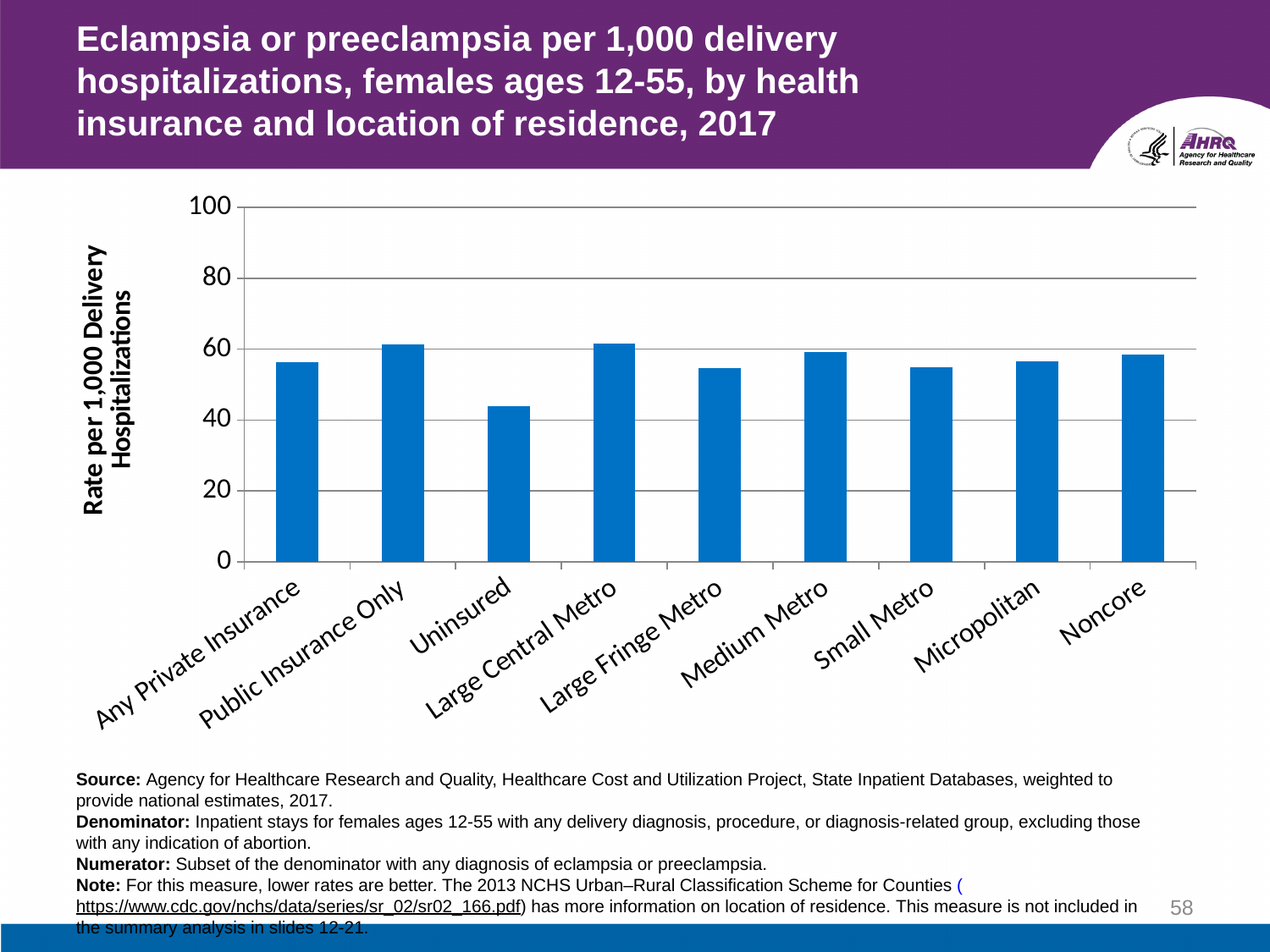
How many categories are shown on the x axis of the chart? 9 Is the value for Uninsured greater or less than 60? less Which has a higher rate, Any Private Insurance or Uninsured? Any Private Insurance Which category has the lowest rate of eclampsia or preeclampsia per 1,000 delivery hospitalizations? Uninsured Is the value for Uninsured greater or less than 40? greater Is the value for Noncore greater or less than 80? less What is the label of the vertical axis of the chart? Rate per 1,000 Delivery Hospitalizations What year of data does the chart title say it shows? 2017 Which has a higher rate, Public Insurance Only or Uninsured? Public Insurance Only What kind of chart is shown on the slide? bar chart